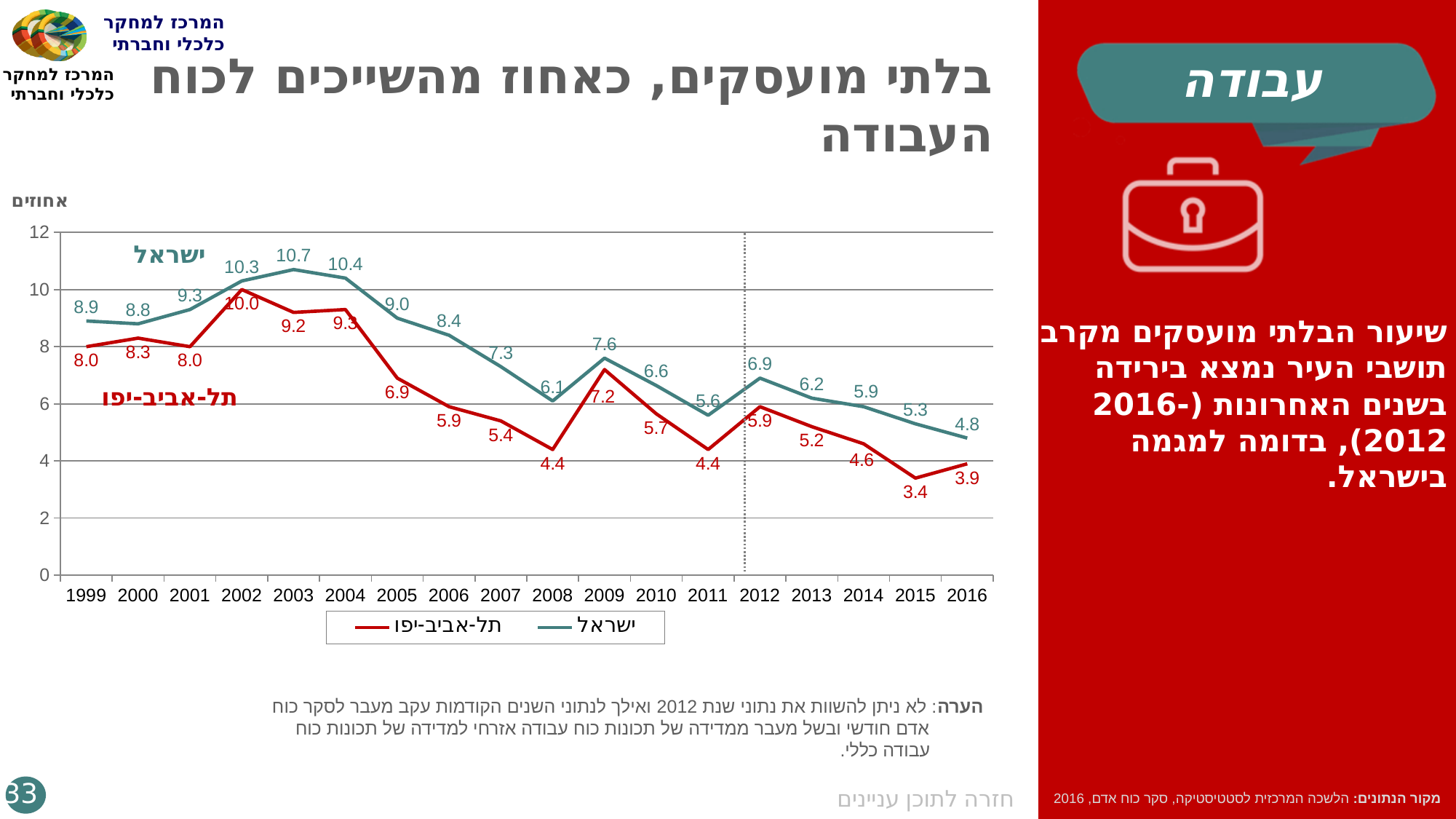
In which year does the תל-אביב-יפו series reach its lowest value? 2015 What is the value for תל-אביב-יפו in 2009? 7.2 Does the ישראל series rise or fall from 2012 to 2016? fall What is the difference between the ישראל and תל-אביב-יפו values in 2016? 0.9 What is the value for ישראל in 2003? 10.7 What is the value for תל-אביב-יפו in 2016? 3.9 How many series does the legend list? 2 In which year does the ישראל series reach its highest value? 2003 Is the value for תל-אביב-יפו in 2002 greater or less than 8? greater Which series has the higher value in 2008, ישראל or תל-אביב-יפו? ישראל How many years are shown on the x axis? 18 What kind of chart is shown on the slide? line chart